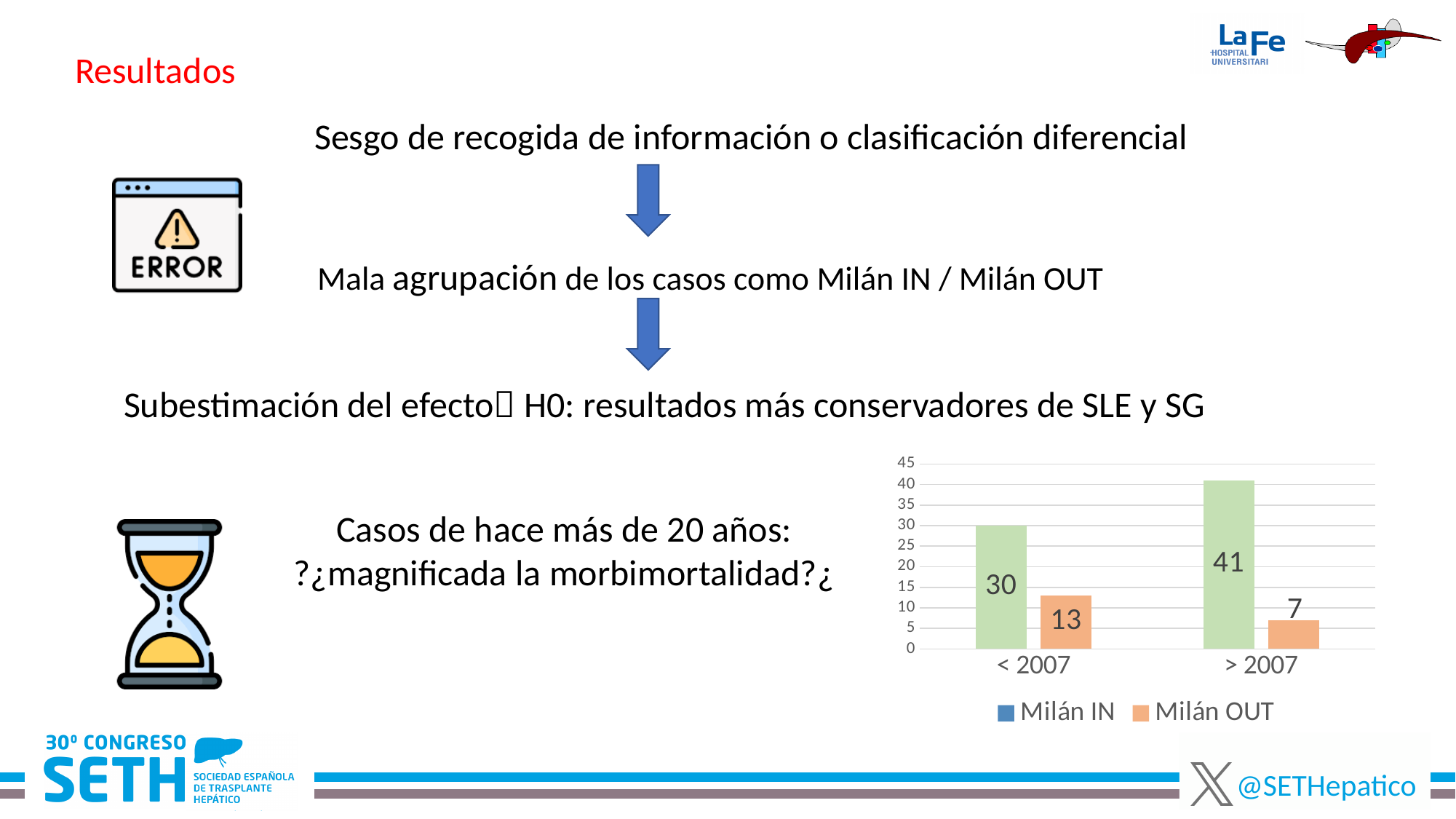
What is the difference between the Milán IN values for > 2007 and < 2007? 11 How many series does the chart legend list? 2 Does the Milán OUT value rise or fall from < 2007 to > 2007? Fall What is the difference between Milán IN and Milán OUT in the > 2007 category? 34 What is the value for Milán IN in the < 2007 category? 30 What is the value for Milán OUT in the < 2007 category? 13 Which category has the highest Milán IN value? > 2007 Which category has the lowest Milán OUT value? > 2007 What kind of chart is shown on the slide? Bar chart How many categories are shown on the x axis of the chart? 2 Which is larger in the < 2007 category, Milán IN or Milán OUT? Milán IN What is the value for Milán OUT in the > 2007 category? 7